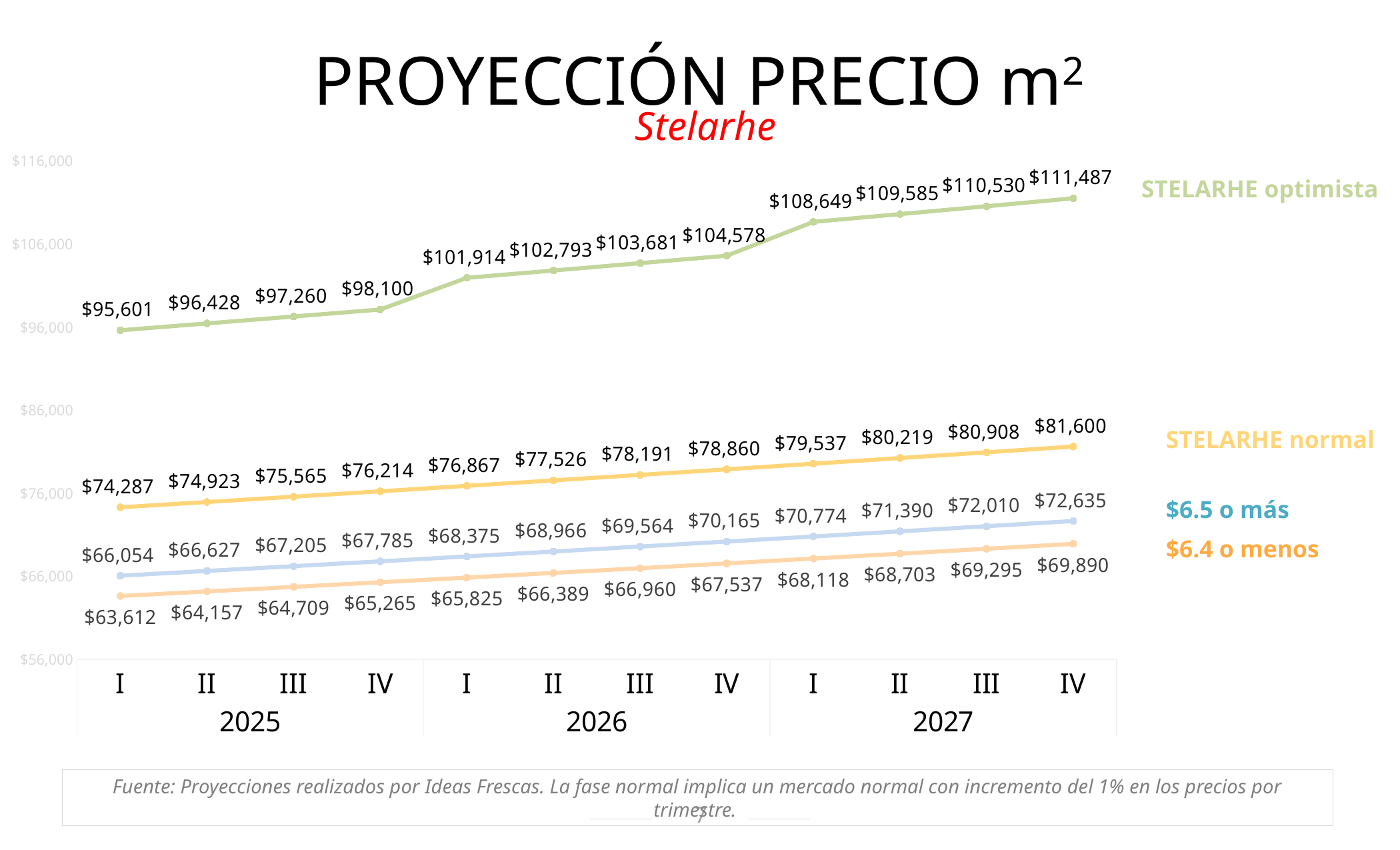
Which series has the lowest value in quarter I of 2025? $6.4 o menos What is the value of the $6.5 o más series in quarter II of 2026? $68,966 In quarter I of 2025, which is larger: the $6.5 o más value or the $6.4 o menos value? $6.5 o más How many quarters are plotted along the x axis? 12 What is the value of the STELARHE normal series in quarter I of 2025? $74,287 What is the value of the $6.4 o menos series in quarter III of 2027? $69,295 What is the value of the STELARHE optimista series in quarter IV of 2027? $111,487 How many series does the chart show? 4 Which series has the highest value in quarter IV of 2027? STELARHE optimista Do the values of the STELARHE normal series rise or fall from 2025 to 2027? rise What is the difference between the STELARHE normal value and the $6.4 o menos value in quarter IV of 2027? $11,710 By how much does the STELARHE optimista series increase from quarter I of 2025 to quarter IV of 2027? $15,886